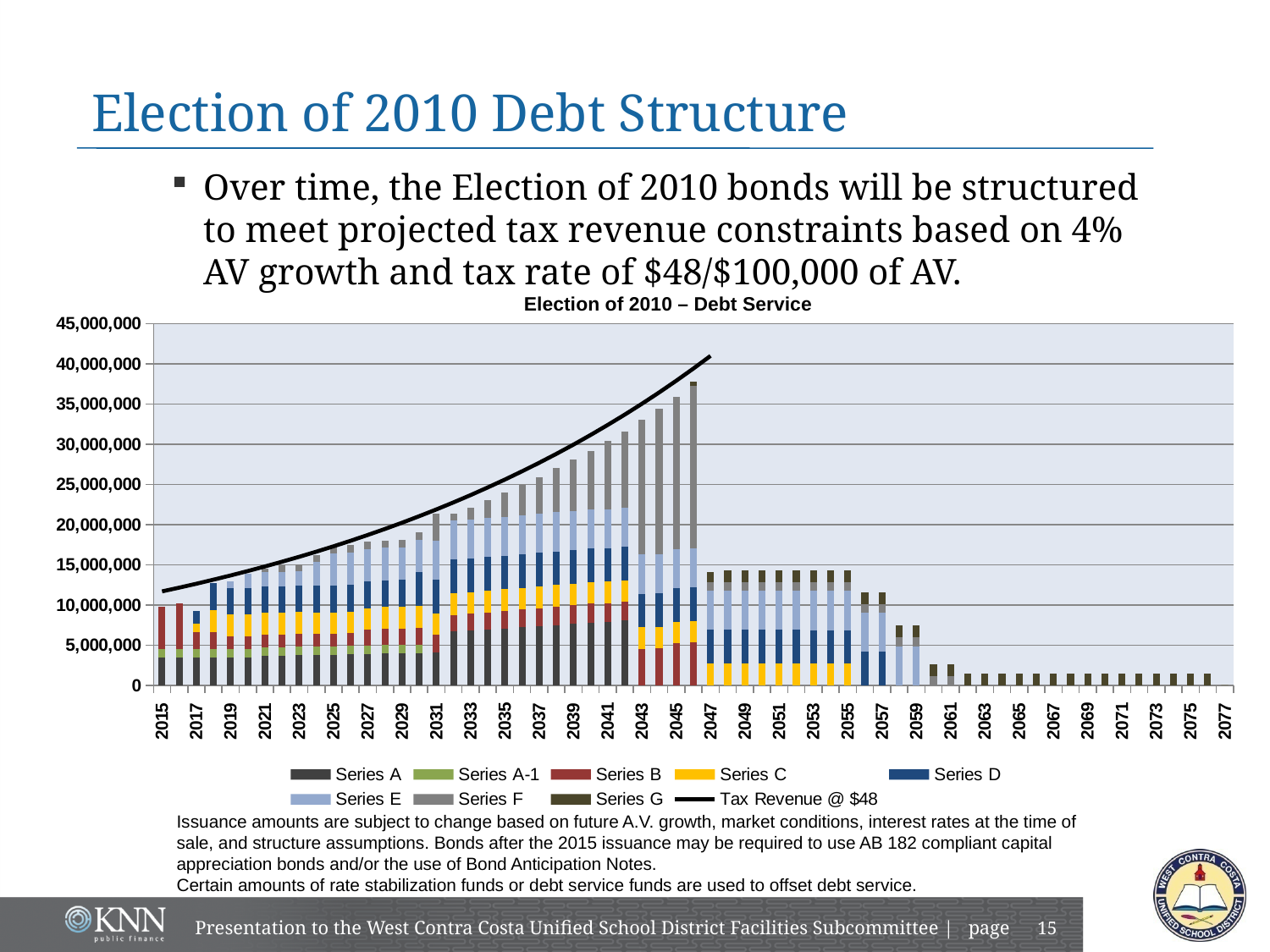
Does the Tax Revenue @ $48 line rise or fall from 2015 to 2046? Rises Is the total debt service bar for 2049 greater or less than 15,000,000? less What is the title of the chart? Election of 2010 – Debt Service How many year labels are shown on the x axis? 32 Is the total debt service bar for 2046 greater or less than 35,000,000? greater What kind of chart is shown on the slide? Stacked bar chart with a line Which year has the tallest stacked bar? 2046 How many entries does the chart legend list? 9 Which year has the larger total debt service bar, 2041 or 2061? 2041 What is the name of the line series in the legend? Tax Revenue @ $48 Is the total debt service bar for 2061 greater or less than 5,000,000? less